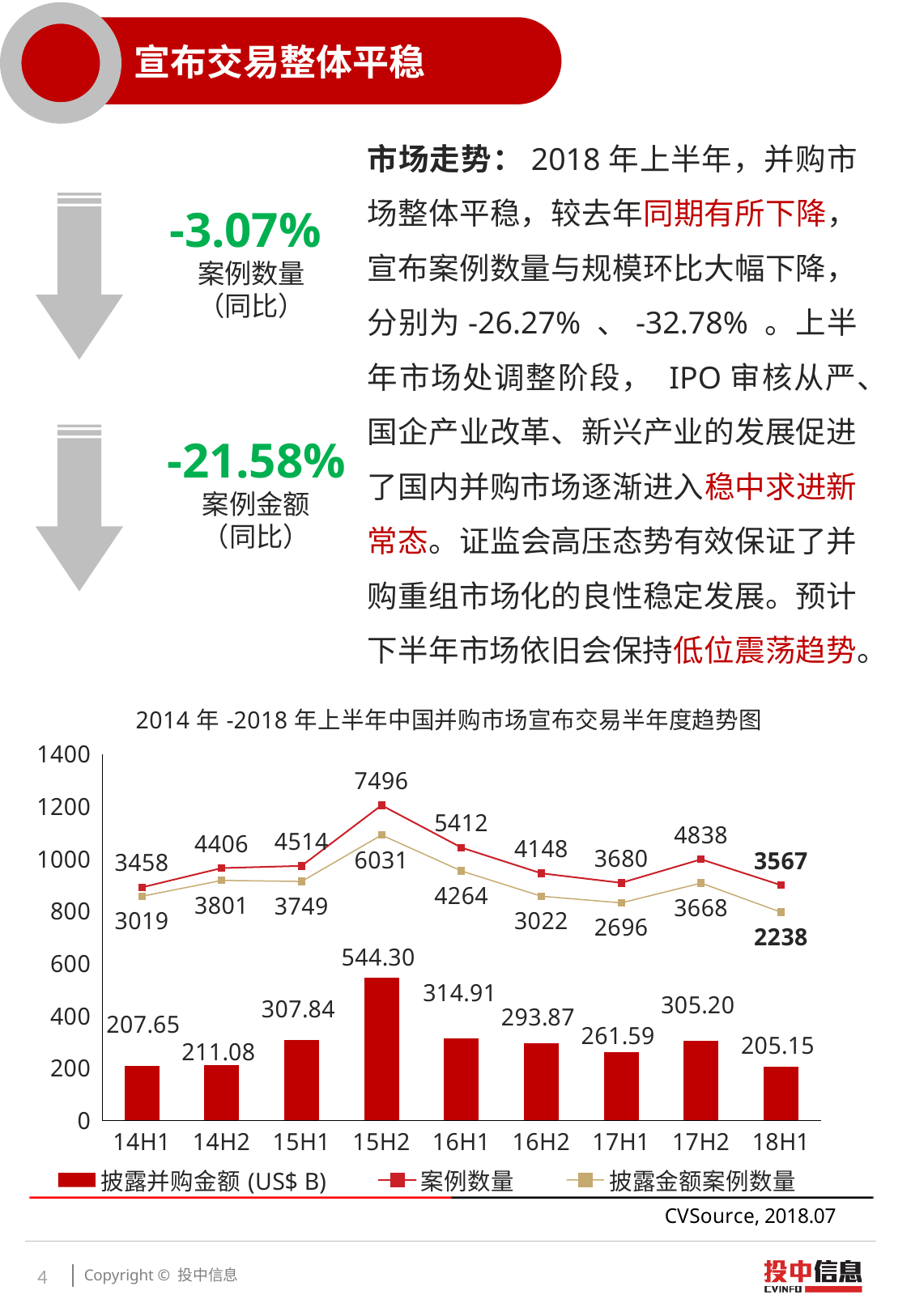
How many series does the chart legend list? 3 How many periods are shown on the x axis of the chart? 9 What is the 披露并购金额 (US$ B) value for 15H2? 544.30 What is the difference between 案例数量 and 披露金额案例数量 for 18H1? 1329 Which period has the highest 案例数量? 15H2 Which period has the lowest 披露并购金额 (US$ B)? 18H1 What is the title of the chart? 2014年-2018年上半年中国并购市场宣布交易半年度趋势图 What is the 披露金额案例数量 value for 17H1? 2696 What is the difference between the 案例数量 values for 15H2 and 16H1? 2084 What kind of chart is shown on the slide? Combined bar and line chart Which is larger, the 披露并购金额 (US$ B) for 16H1 or for 17H2? 16H1 What is the 案例数量 value for 18H1? 3567